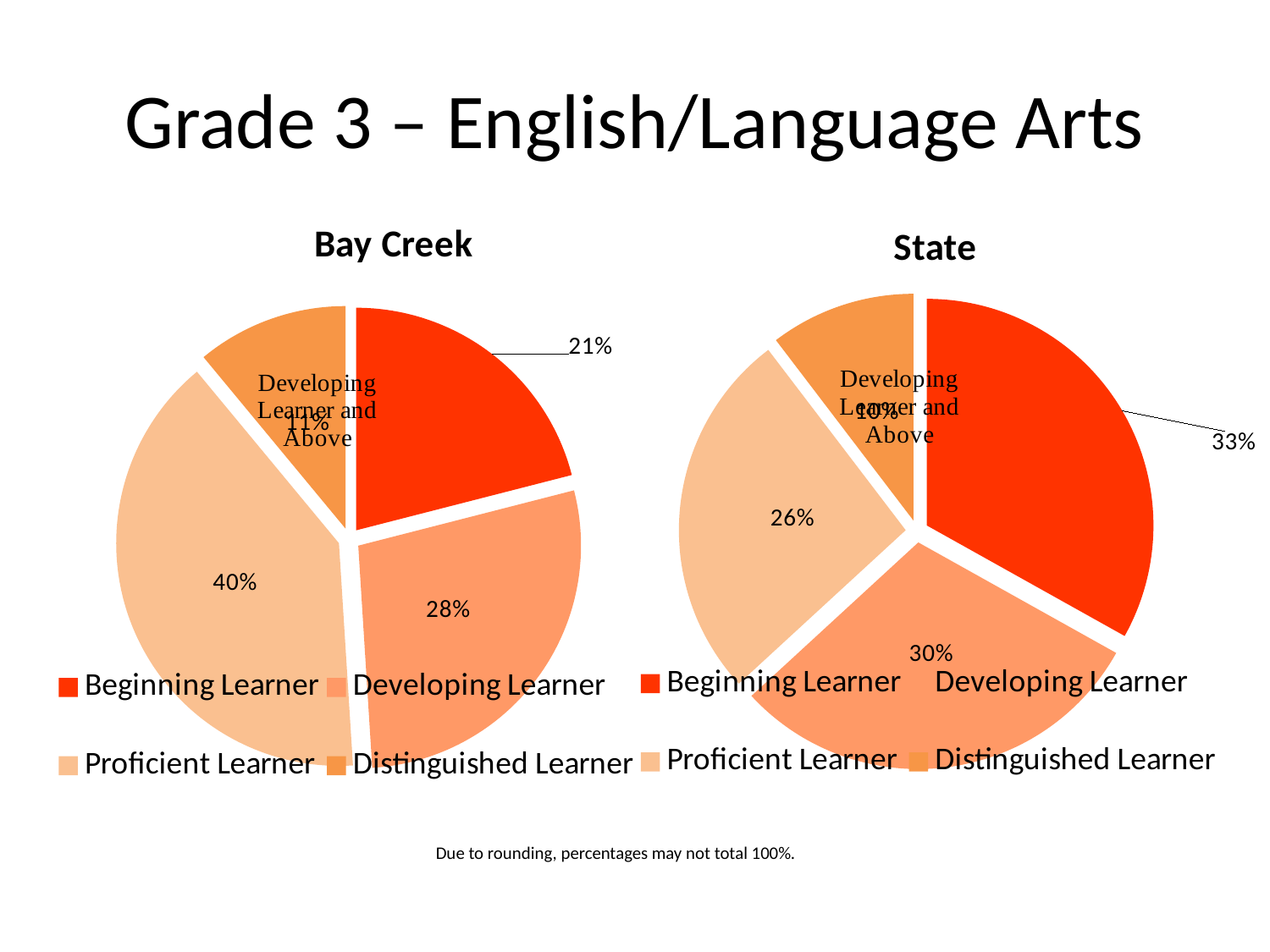
In the Bay Creek pie chart, which is larger: Developing Learner or Beginning Learner? Developing Learner What is the difference between the Beginning Learner share in the State chart and the Beginning Learner share in the Bay Creek chart? 12% In the State pie chart, what percentage is Developing Learner? 30% What type of chart is used for Bay Creek and State? Pie chart In the State pie chart, what percentage is Beginning Learner? 33% In the Bay Creek pie chart, what percentage is Distinguished Learner? 11% In the Bay Creek pie chart, which category has the largest share? Proficient Learner In the Bay Creek pie chart, which category has the smallest share? Distinguished Learner In the Bay Creek pie chart, what percentage is Beginning Learner? 21% In the State pie chart, which category has the largest share? Beginning Learner In the Bay Creek pie chart, what percentage is Proficient Learner? 40% In the State pie chart, what percentage is Proficient Learner? 26%